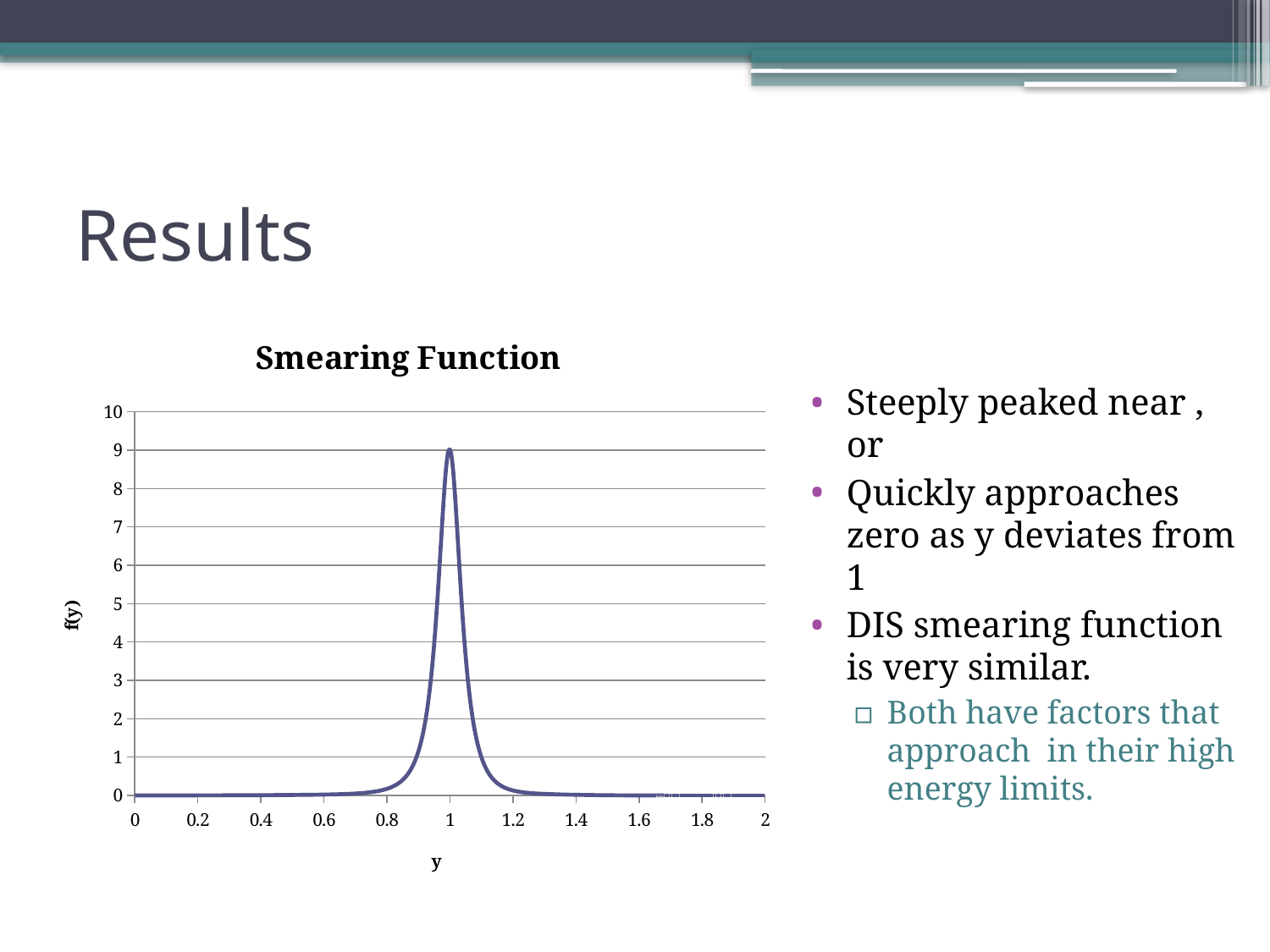
What is the label of the vertical axis of the Smearing Function chart? f(y) How many tick labels are shown on the horizontal axis of the Smearing Function chart? 11 Is the value of the Smearing Function curve at y = 1.6 greater or less than 1? less Is the peak value of the Smearing Function curve greater or less than 8? greater Is the value of the Smearing Function curve at y = 0.4 greater or less than 1? less At which value of y does the Smearing Function curve reach its maximum? 1 What is the title of the chart on the slide? Smearing Function What is the highest value shown on the vertical axis of the Smearing Function chart? 10 What kind of chart is the Smearing Function chart? line chart Does the Smearing Function curve rise or fall as y goes from 1 to 2? fall Does the Smearing Function curve rise or fall as y goes from 0 to 1? rise